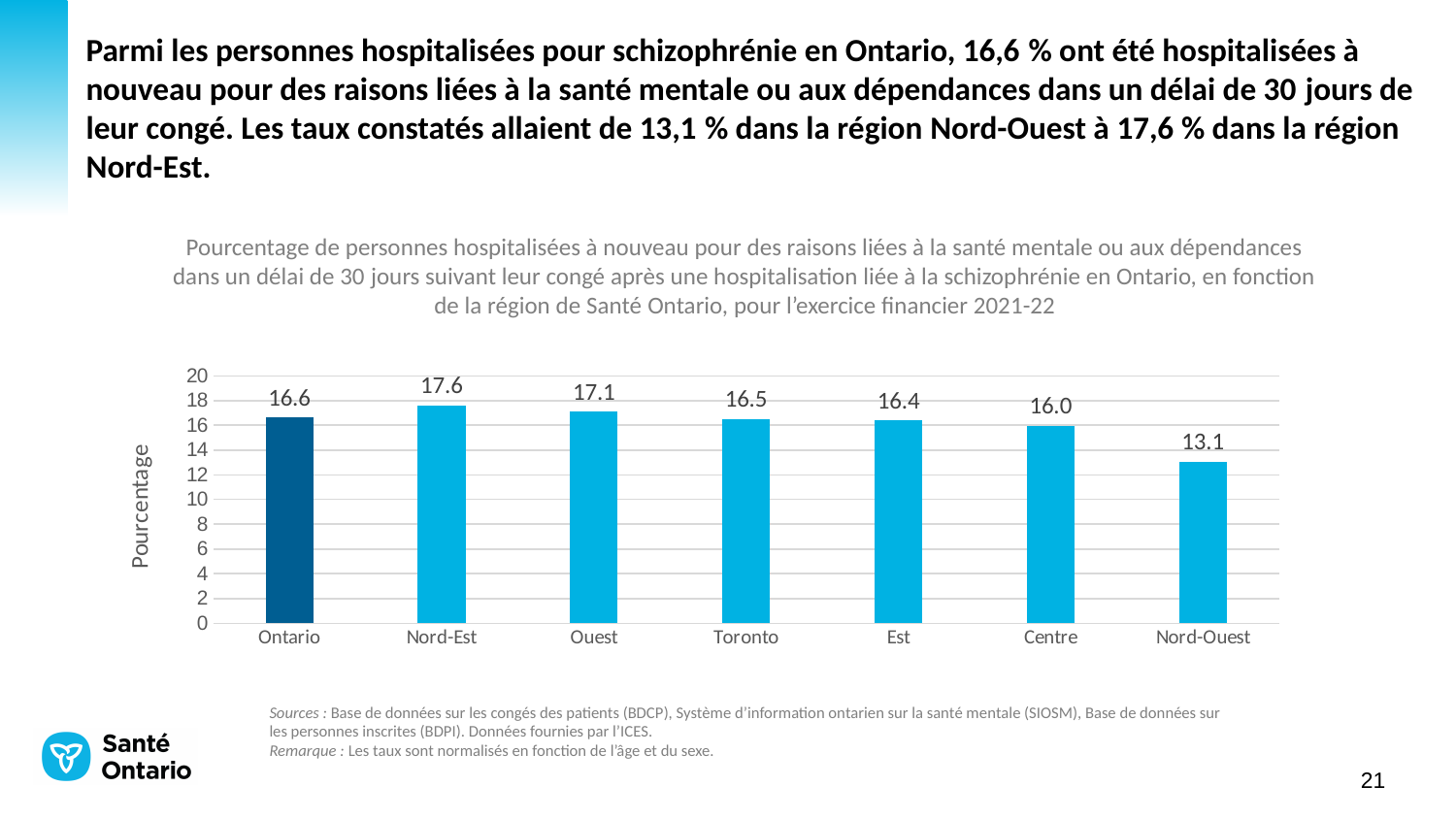
What is the label of the y axis? Pourcentage Which category has the lowest value? Nord-Ouest What is the value for Ontario? 16.6 Which category has the highest value? Nord-Est What is the value for Nord-Ouest? 13.1 What is the value for Toronto? 16.5 What is the value for Nord-Est? 17.6 What kind of chart is shown on the slide? Bar chart Which is larger, the value for Ouest or the value for Est? Ouest What is the difference between the values for Ouest and Centre? 1.1 How many categories are shown on the x axis? 7 What is the difference between the values for Nord-Est and Nord-Ouest? 4.5